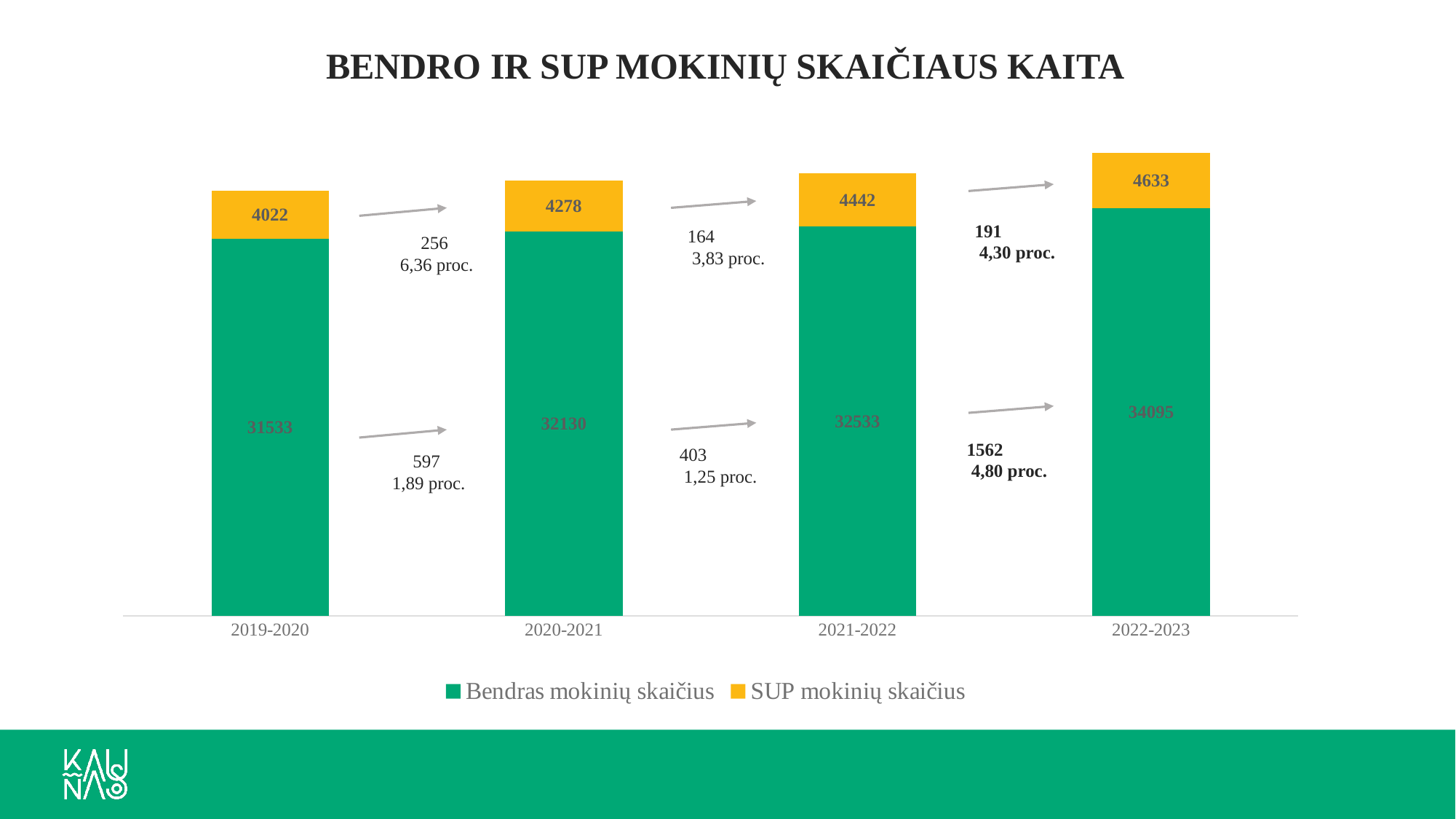
What is the title of the chart? BENDRO IR SUP MOKINIŲ SKAIČIAUS KAITA Which school year has the highest value for Bendras mokinių skaičius? 2022-2023 What is the value of SUP mokinių skaičius for 2020-2021? 4278 What is the total of the stacked bar for 2021-2022? 36975 Do the values for SUP mokinių skaičius rise or fall from 2019-2020 to 2022-2023? rise How many series does the legend list? 2 How many school-year categories are shown on the x axis? 4 What is the value of SUP mokinių skaičius for 2022-2023? 4633 What is the value of Bendras mokinių skaičius for 2019-2020? 31533 What type of chart is shown on the slide? stacked bar chart What is the difference between Bendras mokinių skaičius in 2022-2023 and in 2019-2020? 2562 Which school year has the lowest value for SUP mokinių skaičius? 2019-2020